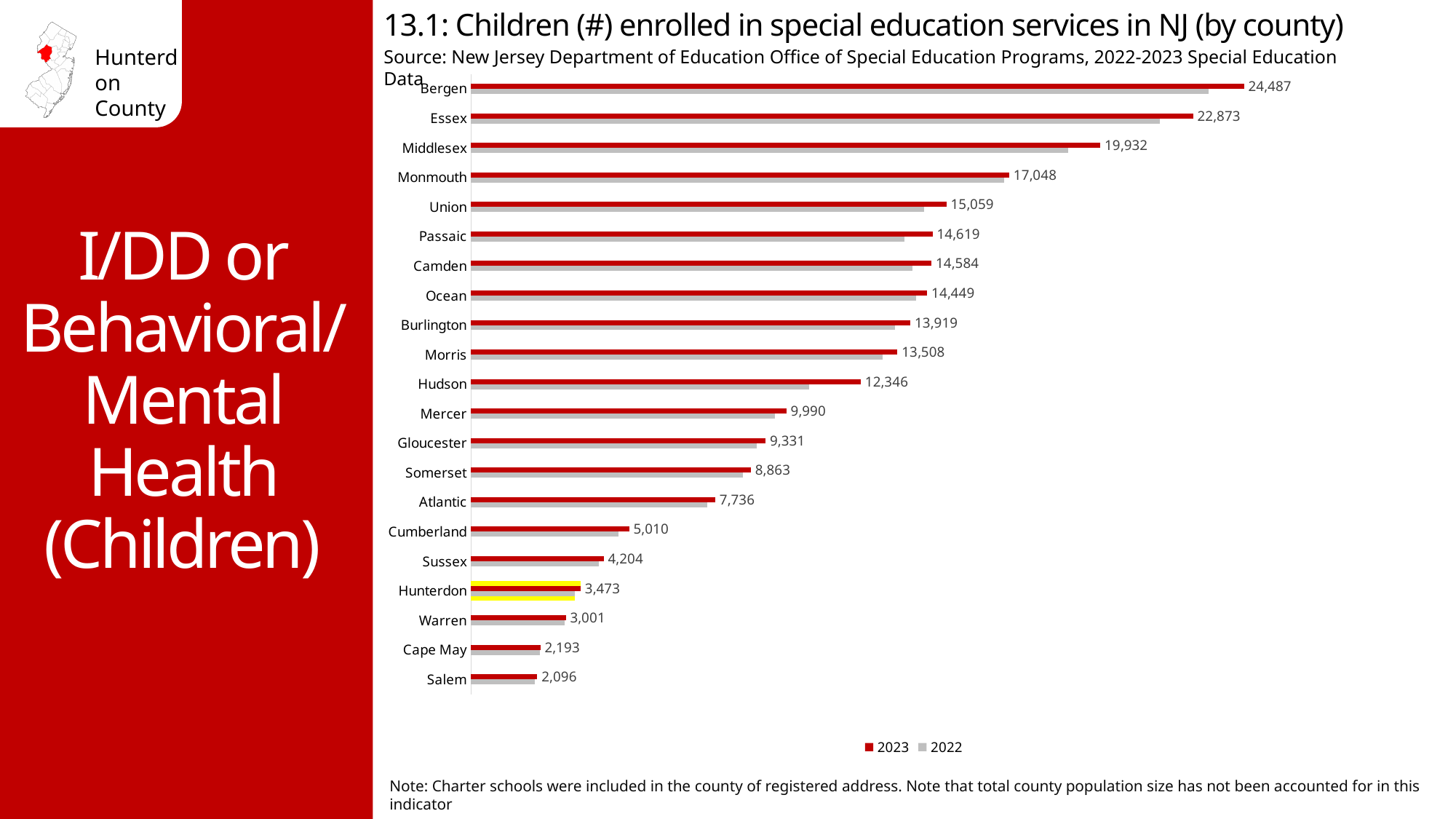
How many counties are shown on the chart? 21 Which has a larger 2023 value, Passaic or Camden? Passaic How many series does the legend list? 2 What is the 2023 value for Cumberland? 5,010 What is the 2023 value for Bergen? 24,487 What is the 2023 value for Hunterdon? 3,473 Which county has the lowest 2023 value? Salem What is the difference between the 2023 values for Bergen and Essex? 1,614 Which series is shown in red? 2023 What is the difference between the 2023 values for Hunterdon and Warren? 472 What kind of chart is shown? Bar chart Which county has the highest 2023 value? Bergen